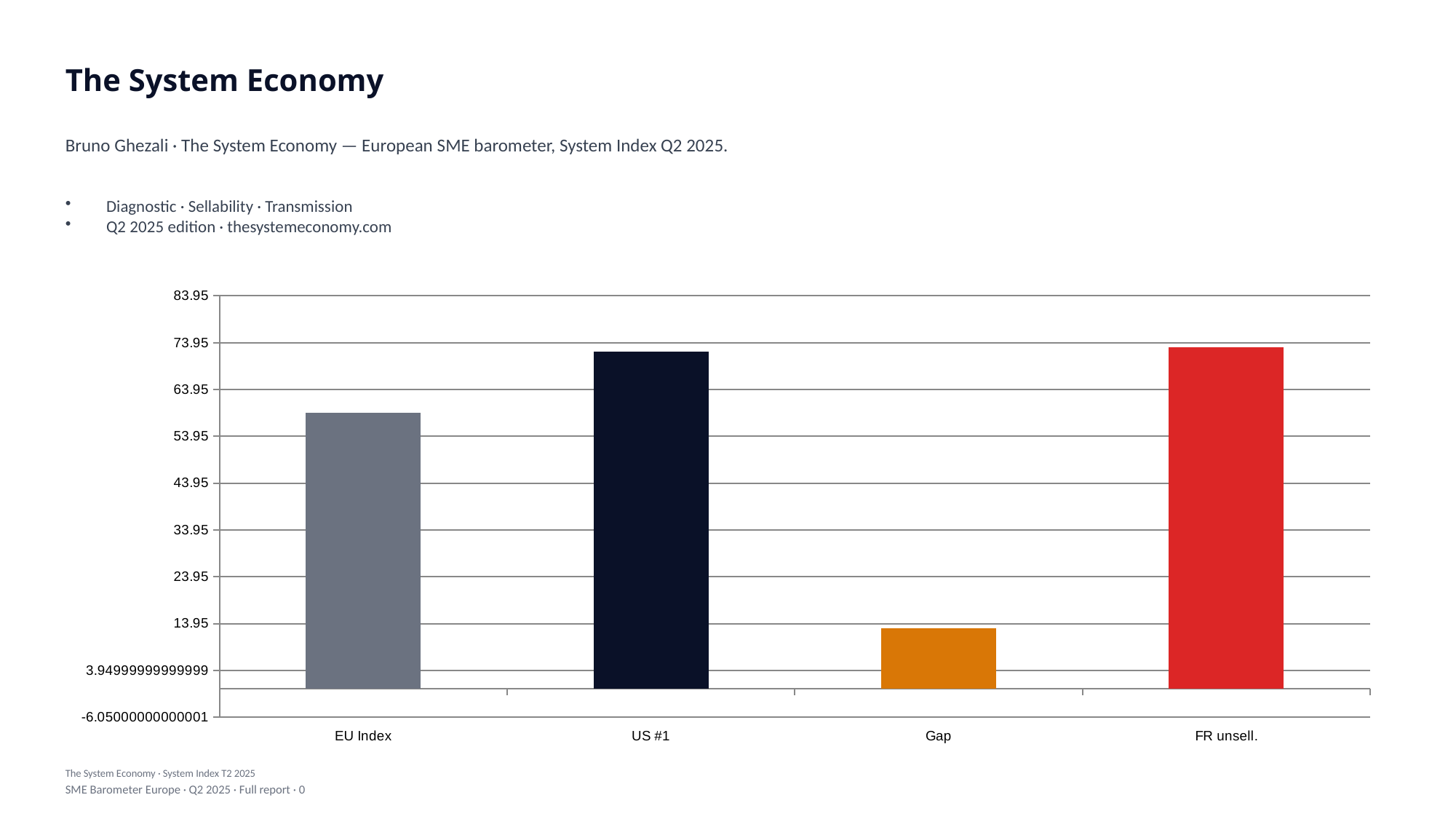
Is the value for FR unsell. greater or less than 53.95? greater Which is larger, the value for Gap or the value for EU Index? EU Index Is the value for Gap greater or less than 23.95? less What is the label of the first category on the x axis? EU Index Which category has the lowest value on the chart? Gap What colour is the bar for Gap? orange What kind of chart is shown on the slide? bar chart Is the value for EU Index greater or less than 63.95? less Which is larger, the value for EU Index or the value for US #1? US #1 How many categories are plotted on the chart? 4 Which is larger, the value for Gap or the value for FR unsell.? FR unsell.